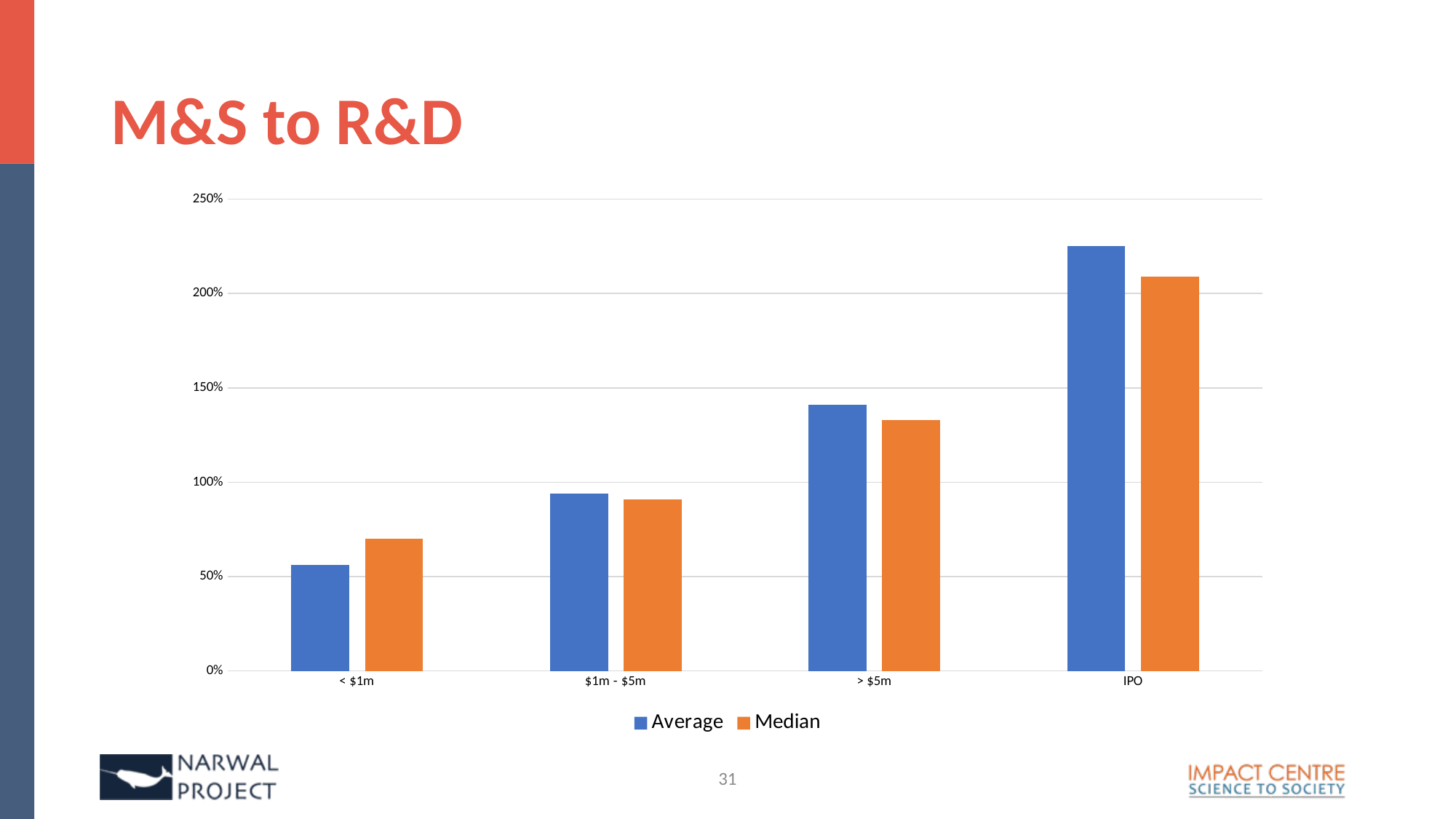
Which category has the lowest Median value? < $1m How many categories are shown on the x axis? 4 What kind of chart is shown on the slide? bar chart Which category has the highest Average value? IPO Which category has the lowest Average value? < $1m Do the Average values rise or fall moving from < $1m to IPO along the x axis? rise Is the Average value for IPO greater or less than 200%? greater How many series does the legend list? 2 Is the Median value for > $5m greater or less than 100%? greater For the IPO category, which is larger, the Average or the Median? Average For the < $1m category, which is larger, the Average or the Median? Median Is the Average value for $1m - $5m greater or less than 100%? less